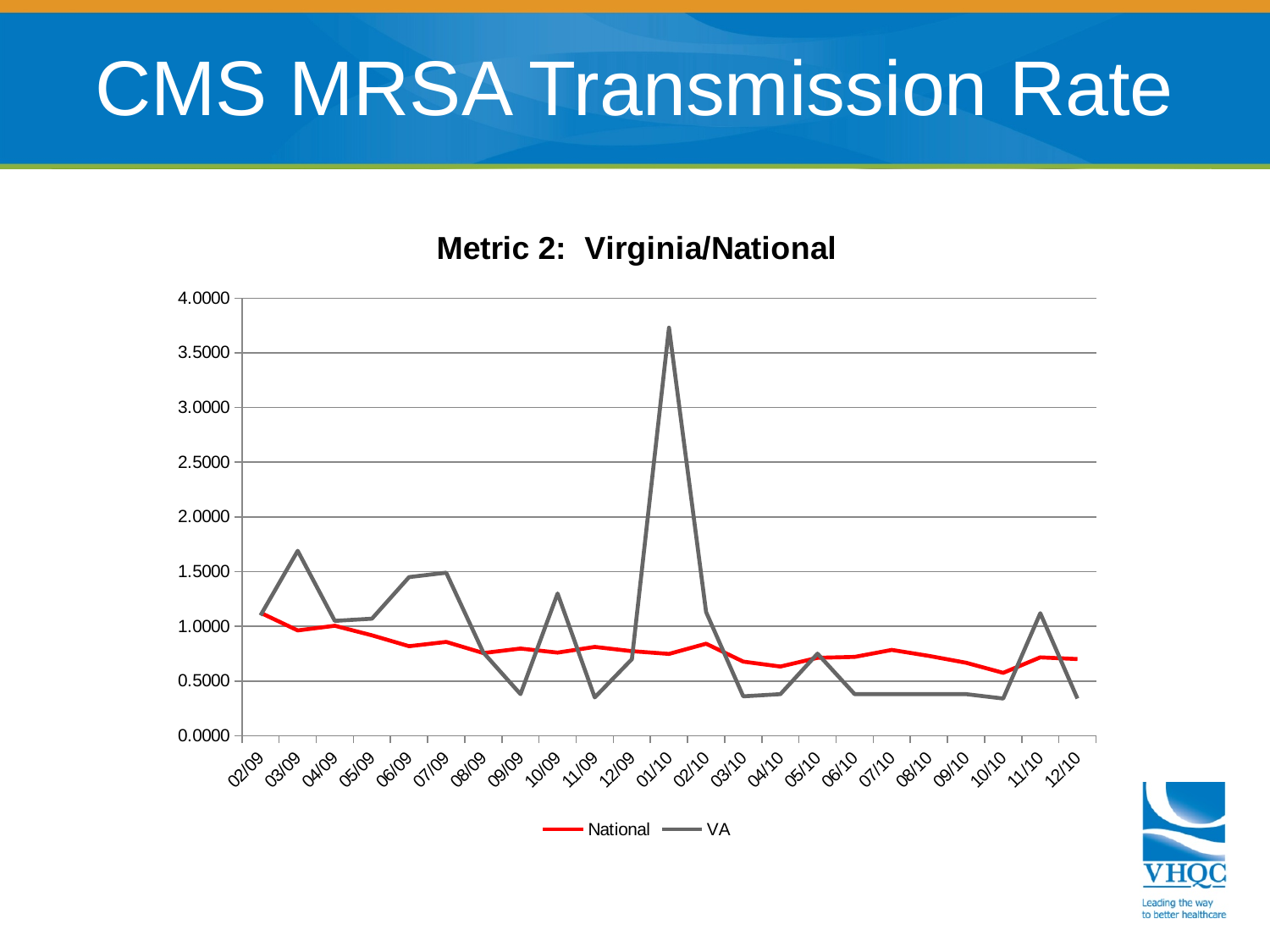
At which month does the VA series reach its highest value? 01/10 Is the VA value for 09/09 greater or less than 0.5000? less At 01/10, which series has the larger value, National or VA? VA At 09/09, which series has the larger value, National or VA? National At which month does the National series reach its highest value? 02/09 What is the title of the chart? Metric 2: Virginia/National Is the VA value for 03/09 greater or less than 1.5000? greater How many series does the legend list? 2 How many time points are plotted along the x axis? 23 Is the National value for 12/10 greater or less than 0.5000? greater What kind of chart is shown on the slide? Line chart